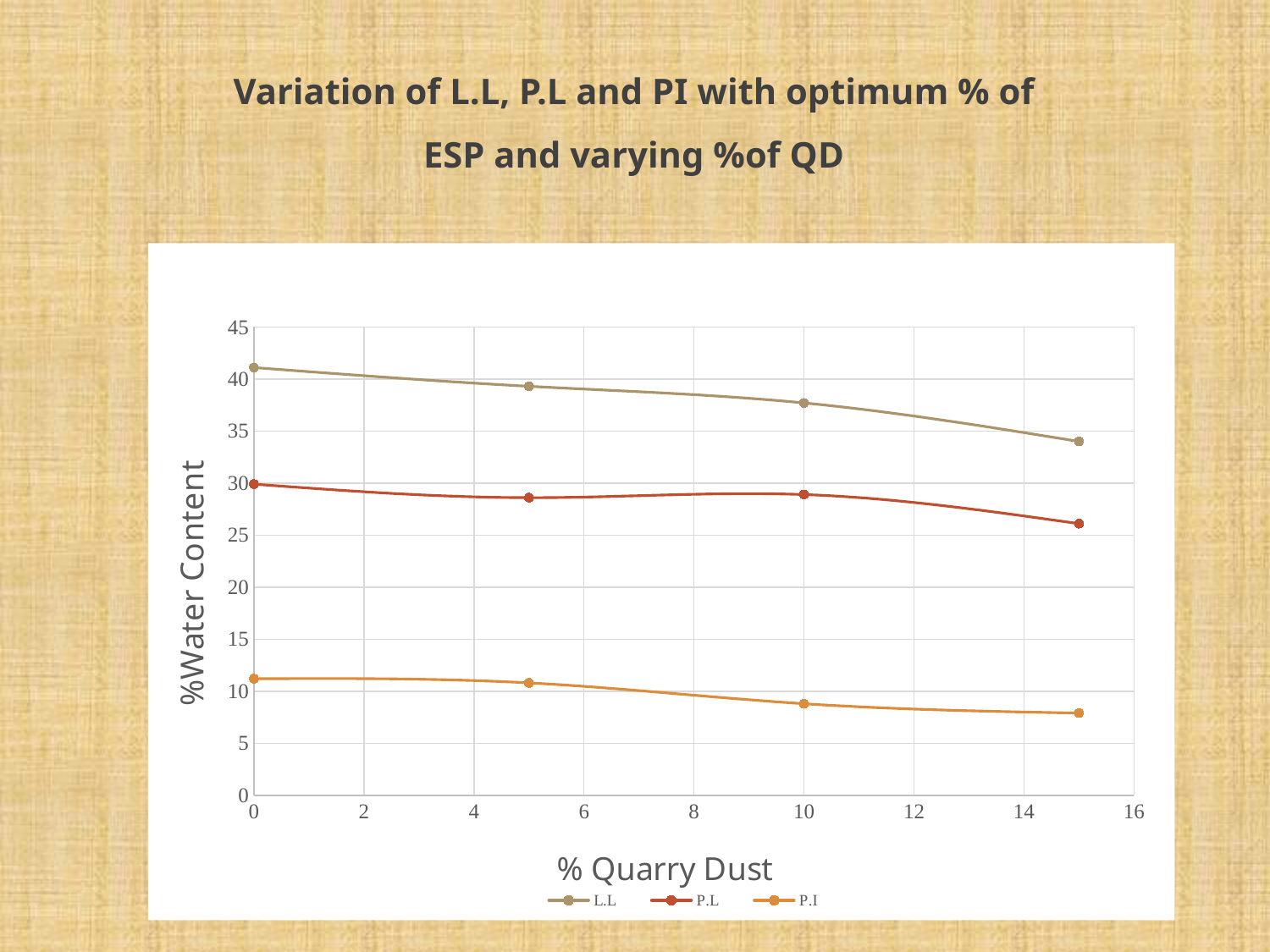
Is the L.L value at 10% Quarry Dust greater or less than 35? greater What is the label of the x axis? % Quarry Dust Which series has the lowest values across the chart? P.I How many series does the legend list? 3 What kind of chart is shown on the slide? Line chart Is the P.L value at 0% Quarry Dust greater or less than 35? less At 10% Quarry Dust, which is larger: the P.L value or the P.I value? P.L Does the L.L series rise or fall as % Quarry Dust increases from 0 to 15? Fall Is the P.I value at 15% Quarry Dust greater or less than 10? less How many data points are plotted for the L.L series? 4 Does the P.I series rise or fall as % Quarry Dust increases from 0 to 15? Fall Which series has the highest values across the chart? L.L